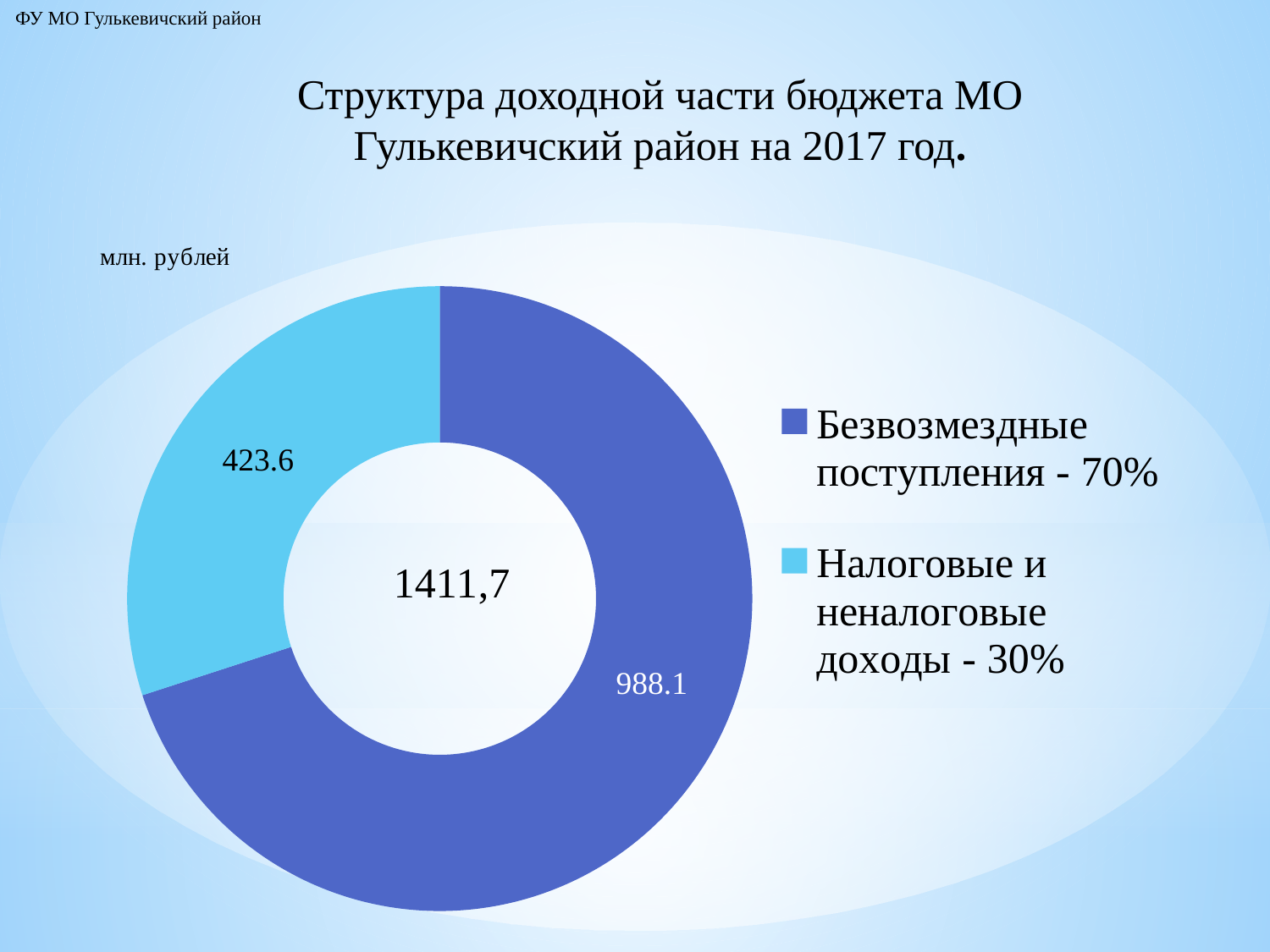
Which is larger: Безвозмездные поступления or Налоговые и неналоговые доходы? Безвозмездные поступления Which category has the smallest value? Налоговые и неналоговые доходы What is the difference between the values for Безвозмездные поступления and Налоговые и неналоговые доходы? 564.5 What share of the total do Безвозмездные поступления make up? 70% What is the value for Безвозмездные поступления? 988.1 What share of the total do Налоговые и неналоговые доходы make up? 30% Which category has the largest value? Безвозмездные поступления What is the value for Налоговые и неналоговые доходы? 423.6 What total value is shown in the centre of the chart? 1411,7 What kind of chart is shown on the slide? Doughnut chart What unit is indicated for the chart values? млн. рублей How many categories does the chart show? 2